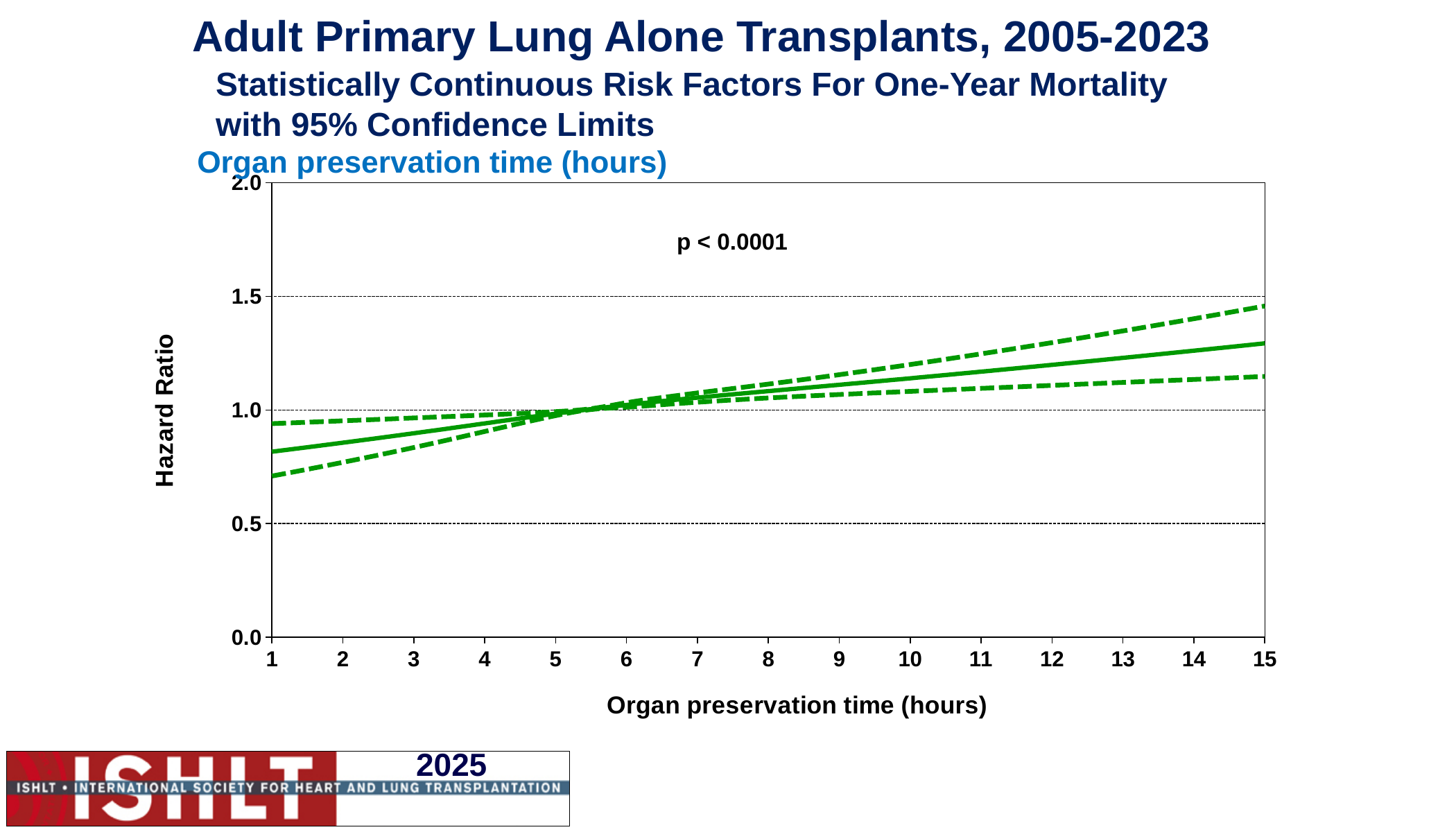
Is the upper 95% confidence limit at 1 hour of organ preservation time greater or less than 1.0? less What p-value is printed on the chart? p < 0.0001 How many tick values are labelled on the x axis (organ preservation time)? 15 Is the hazard ratio (solid line) at 10 hours of organ preservation time greater or less than 1.0? greater What is the label of the y axis? Hazard Ratio Does the hazard ratio (solid line) rise or fall as organ preservation time increases from 1 to 15 hours? rise Is the hazard ratio (solid line) at 15 hours of organ preservation time greater or less than 1.5? less Which is larger, the hazard ratio (solid line) at 3 hours or at 12 hours of organ preservation time? 12 hours What kind of chart is shown on the slide? line chart